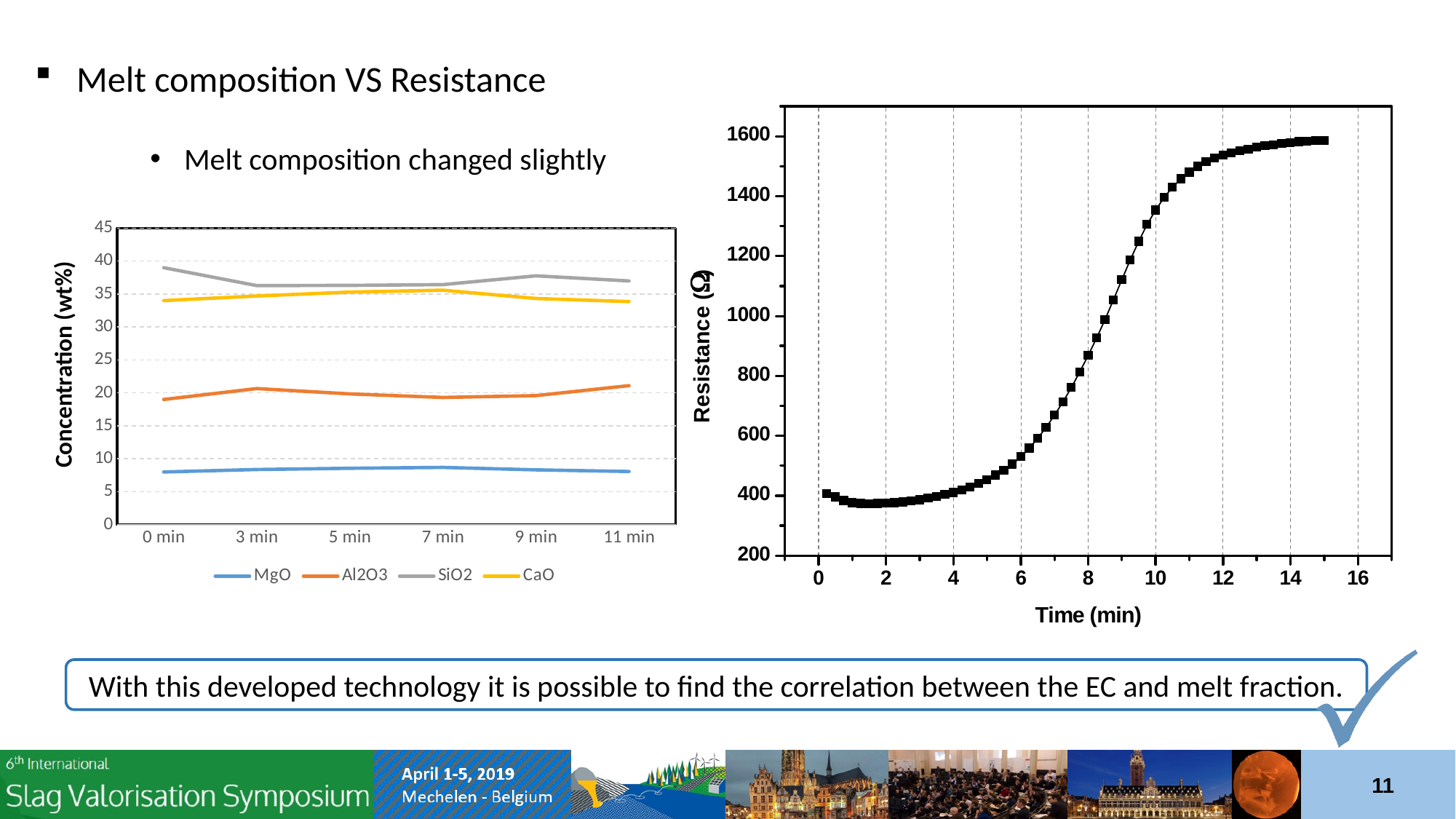
In the right chart, what is the label of the x axis? Time (min) In the left concentration chart, is the MgO value at 0 min greater or less than 10? less In the left concentration chart, which series has the highest concentration at 0 min? SiO2 In the right resistance chart, does the resistance generally rise or fall as time increases? rise In the left concentration chart, is the SiO2 value at 0 min greater or less than 35? greater In the right resistance chart, is the resistance at 2 min greater or less than 600? less How many time points are shown on the x axis of the left concentration chart? 6 In the left concentration chart, which series has the lowest concentration throughout? MgO How many series does the legend of the left concentration chart list? 4 What type of chart is the left chart titled with the y-axis 'Concentration (wt%)'? line chart In the left concentration chart, which is larger at 11 min: Al2O3 or CaO? CaO